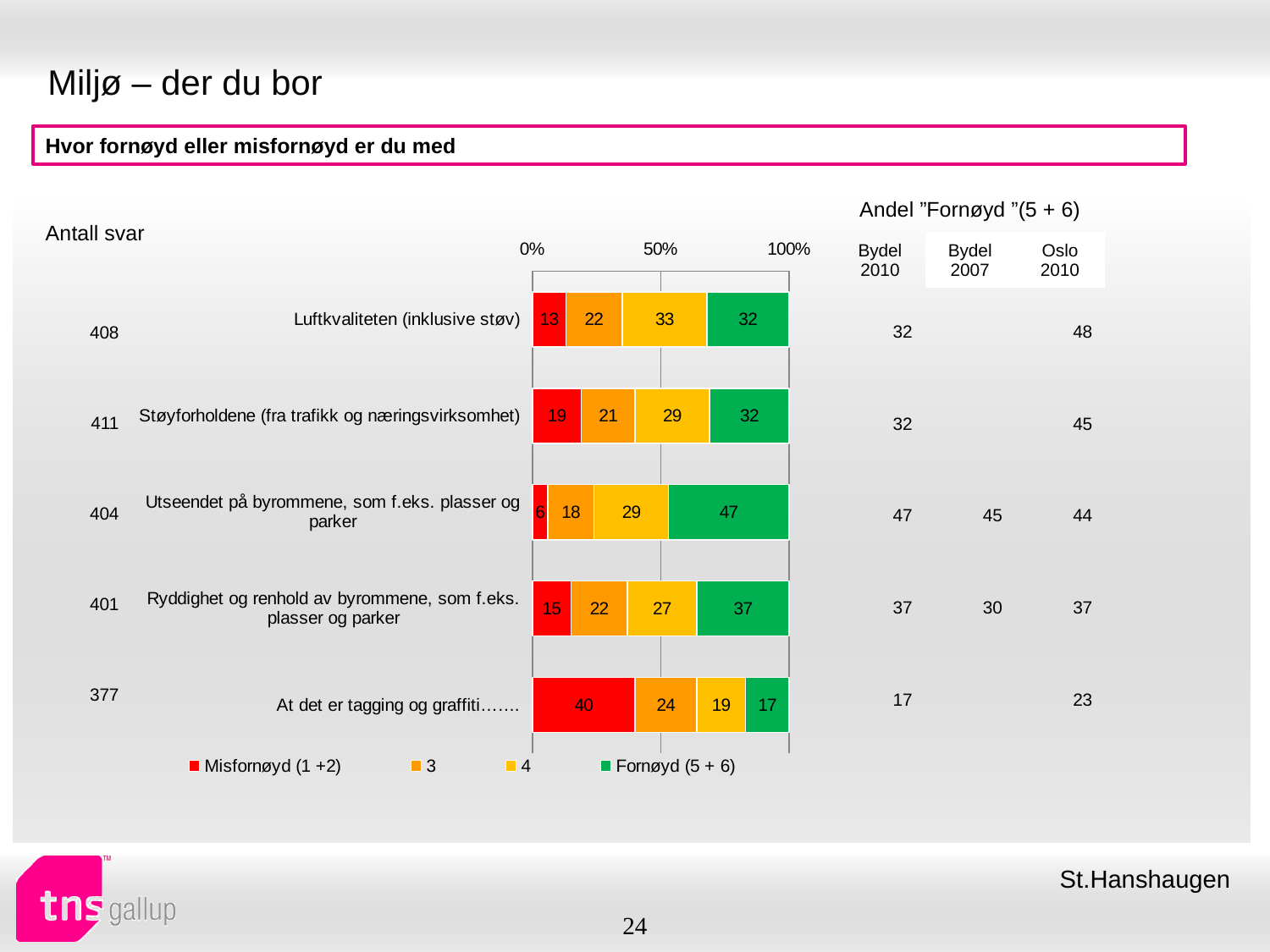
What kind of chart is shown on the slide? Stacked bar chart What is the value of the "4" segment for "Ryddighet og renhold av byrommene, som f.eks. plasser og parker"? 27 Which category has the highest "Fornøyd (5 + 6)" value? Utseendet på byrommene, som f.eks. plasser og parker Which category has the lowest "Misfornøyd (1 +2)" value? Utseendet på byrommene, som f.eks. plasser og parker What is the value of the "Fornøyd (5 + 6)" segment for "Luftkvaliteten (inklusive støv)"? 32 Which is larger: the "Misfornøyd (1 +2)" value for "Støyforholdene (fra trafikk og næringsvirksomhet)" or for "Luftkvaliteten (inklusive støv)"? Støyforholdene (fra trafikk og næringsvirksomhet) How many categories are shown in the chart? 5 What is the difference between the "Fornøyd (5 + 6)" values for "Utseendet på byrommene, som f.eks. plasser og parker" and "At det er tagging og graffiti……."? 30 How many series does the legend list? 4 What is the total of the stacked bar for "Luftkvaliteten (inklusive støv)"? 100 What is the value of the "3" segment for "Støyforholdene (fra trafikk og næringsvirksomhet)"? 21 What is the value of the "Misfornøyd (1 +2)" segment for "At det er tagging og graffiti……."? 40